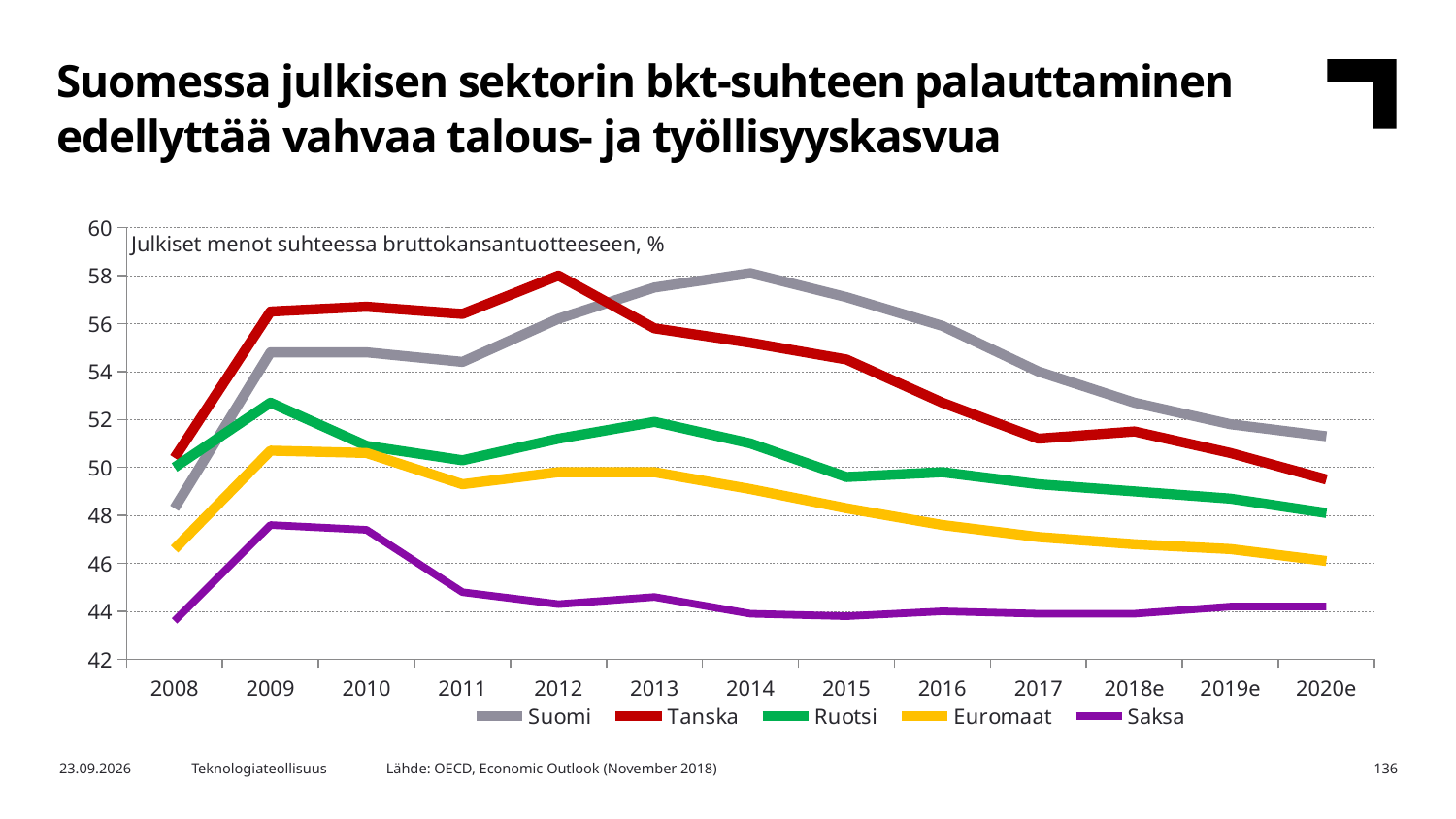
Is the value for Ruotsi in 2009 greater or less than 52? greater How many series does the legend list? 5 In 2014, which is larger: the value for Suomi or the value for Tanska? Suomi Which series has the highest value in 2016? Suomi In 2013, which is larger: the value for Ruotsi or the value for Euromaat? Ruotsi What kind of chart is shown on the slide? Line chart Which series has the highest value in 2009? Tanska Which series has the lowest value in 2012? Saksa Is the value for Saksa in 2011 greater or less than 46? less How many years are shown on the x axis? 13 Does the value for Suomi rise or fall from 2014 to 2020e? fall What text is shown inside the chart area describing what is plotted? Julkiset menot suhteessa bruttokansantuotteeseen, %